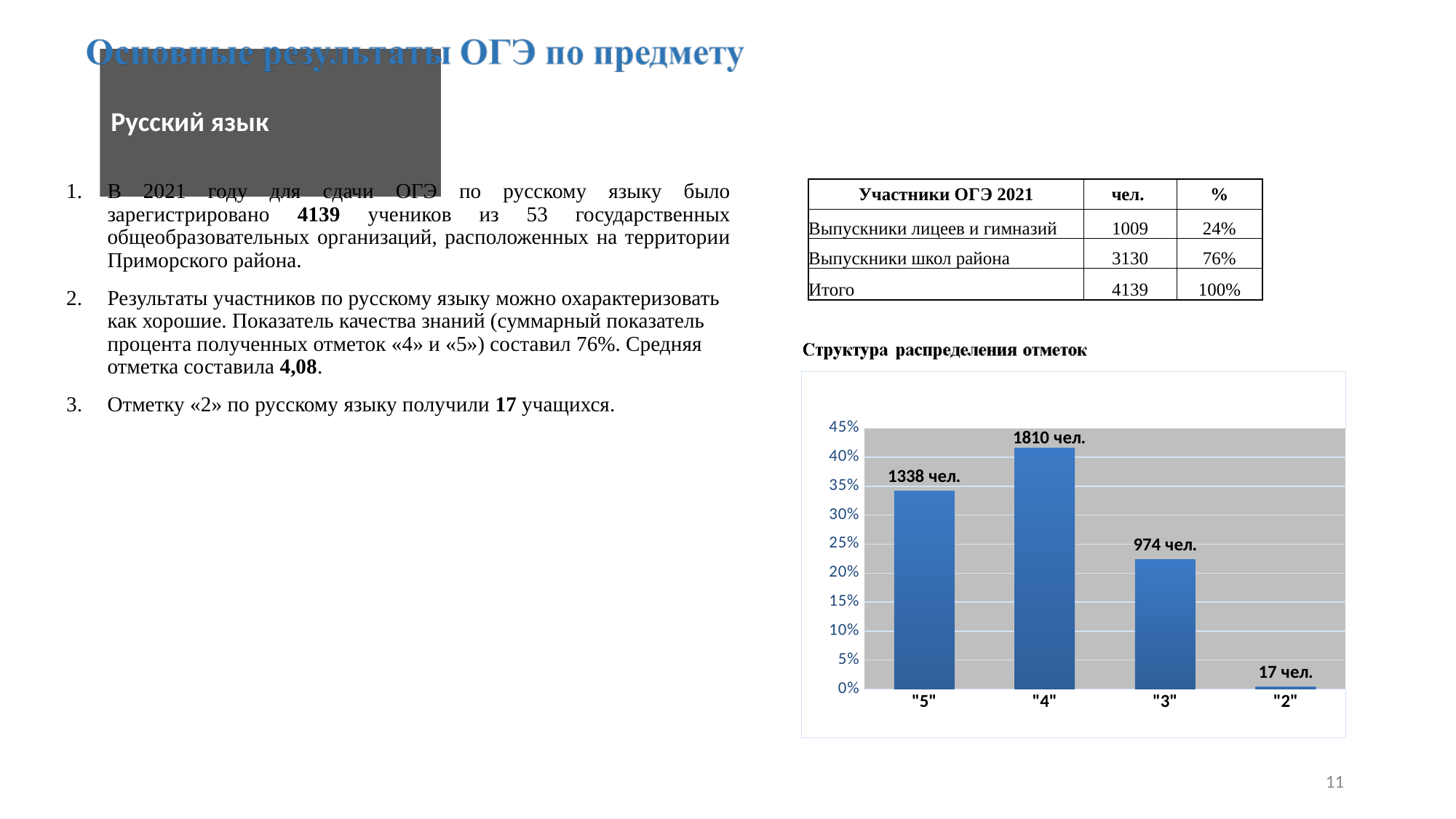
What is the data label for the "4" bar in the Структура распределения отметок chart? 1810 чел. In the Структура распределения отметок chart, is the value for "3" greater or less than 25%? less Which category has the lowest bar in the Структура распределения отметок chart? "2" In the Структура распределения отметок chart, which bar is larger: "5" or "3"? "5" What is the data label for the "2" bar in the Структура распределения отметок chart? 17 чел. How many categories are shown on the x axis of the Структура распределения отметок chart? 4 Which category has the highest bar in the Структура распределения отметок chart? "4" In the Структура распределения отметок chart, is the value for "5" greater or less than 30%? greater What is the data label for the "5" bar in the Структура распределения отметок chart? 1338 чел. In the Структура распределения отметок chart, how many more people are in the "4" bar than in the "5" bar? 472 чел. What is the data label for the "3" bar in the Структура распределения отметок chart? 974 чел. What kind of chart is the Структура распределения отметок chart? bar chart